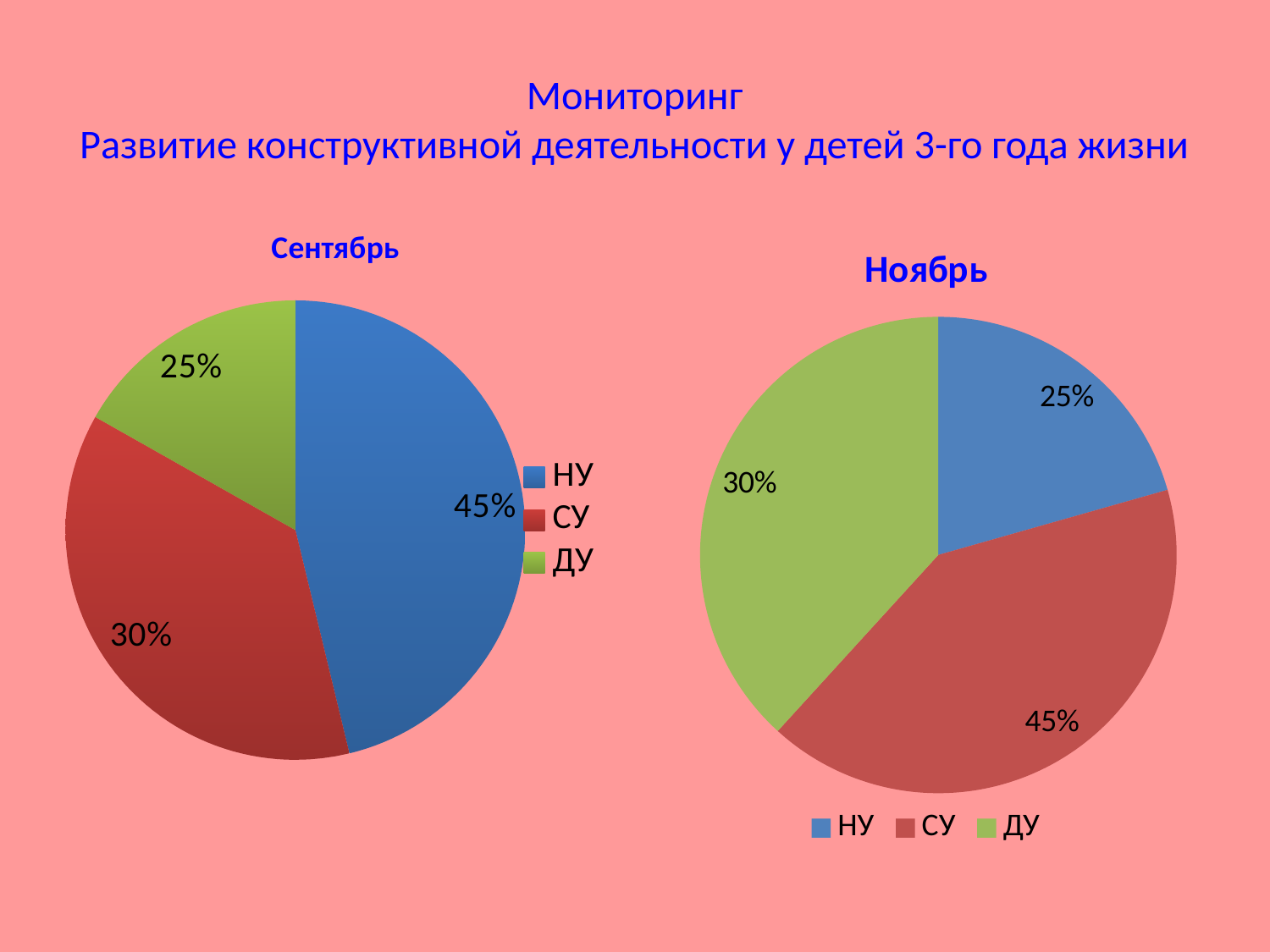
In the "Сентябрь" chart, what is the value for ДУ? 25% In the "Сентябрь" chart, which is larger, СУ or ДУ? СУ In the "Ноябрь" chart, which category has the smallest slice? НУ In the "Ноябрь" chart, what is the value for НУ? 25% In the "Ноябрь" chart, what is the difference between СУ and ДУ? 15% In the "Ноябрь" chart, what colour is the ДУ slice? green In the "Ноябрь" chart, what is the value for СУ? 45% In the "Сентябрь" chart, which category has the largest slice? НУ In the "Сентябрь" chart, what is the value for НУ? 45% How many entries does the legend of the "Сентябрь" chart list? 3 How many slices does the "Ноябрь" chart have? 3 What kind of chart is the "Сентябрь" chart? pie chart